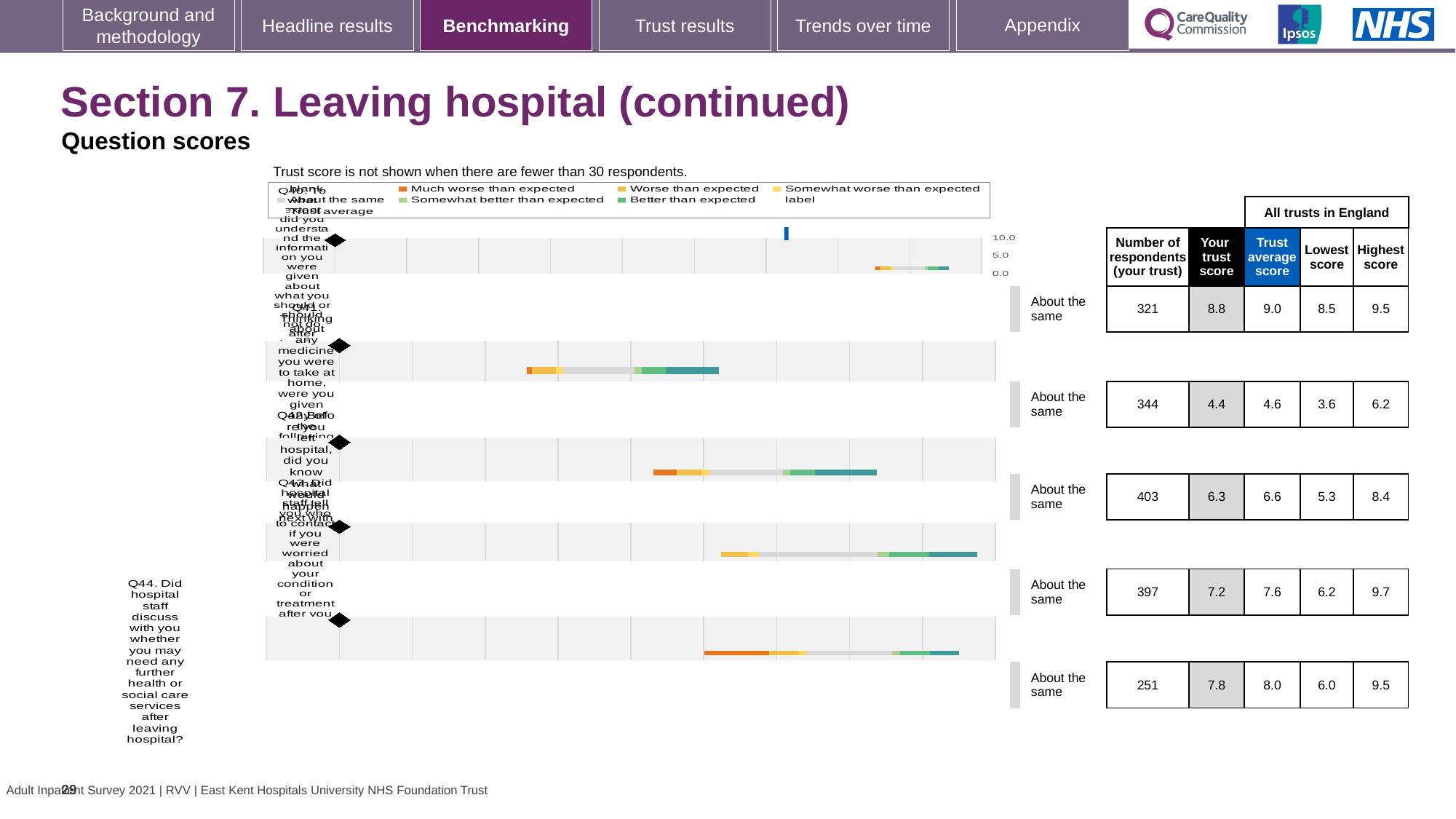
According to the note above the chart, when is the trust score not shown? When there are fewer than 30 respondents How many question rows are plotted in the chart? 5 Which question row has the lowest 'Your trust score'? The second row (344 respondents), 4.4 What is the highest score across all trusts in England for Q44? 9.5 What benchmark category is shown for Q44? About the same For Q44, what is the difference between the highest score and the lowest score across all trusts in England? 3.5 Which question row has the highest 'Your trust score'? The first row (321 respondents), 8.8 How many respondents answered Q44 at this trust? 251 What is the 'Your trust score' for Q44 (Did hospital staff discuss with you whether you may need any further health or social care services after leaving hospital?)? 7.8 For Q44, which is larger: the trust's own score or the trust average score? Trust average score (8.0) What kind of chart is used to show the question scores on this slide? bar chart What is the trust average score for Q44? 8.0